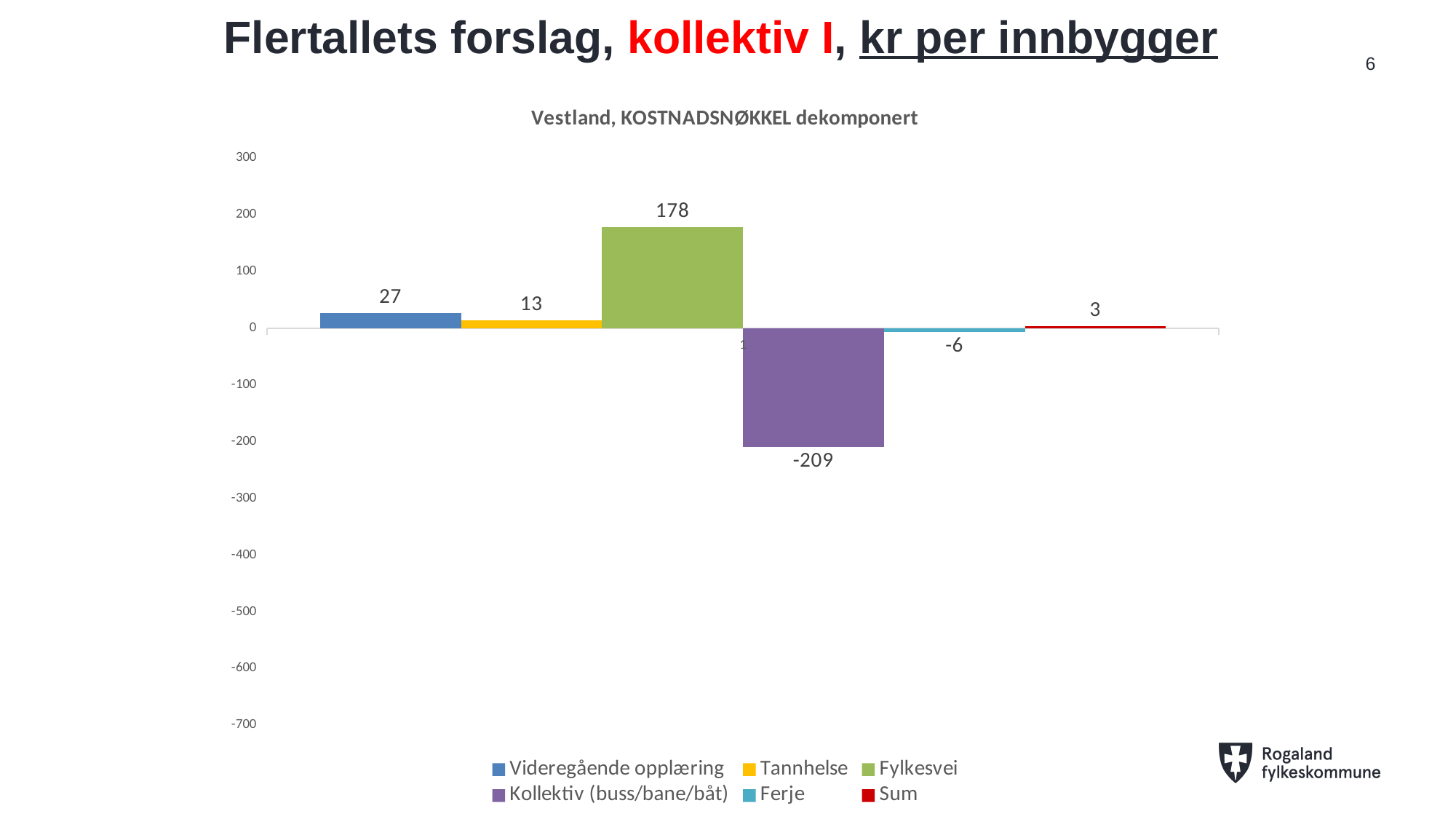
What is the value for Videregående opplæring? 27 What is the value for Sum? 3 What is the value for Kollektiv (buss/bane/båt)? -209 What is the difference between the values for Fylkesvei and Videregående opplæring? 151 Which series has the lowest value? Kollektiv (buss/bane/båt) What is the title of the chart? Vestland, KOSTNADSNØKKEL dekomponert How many series does the legend list? 6 Which is larger, the value for Videregående opplæring or the value for Tannhelse? Videregående opplæring What is the value for Ferje? -6 What is the value for Fylkesvei? 178 Which series has the highest value? Fylkesvei What is the value for Tannhelse? 13